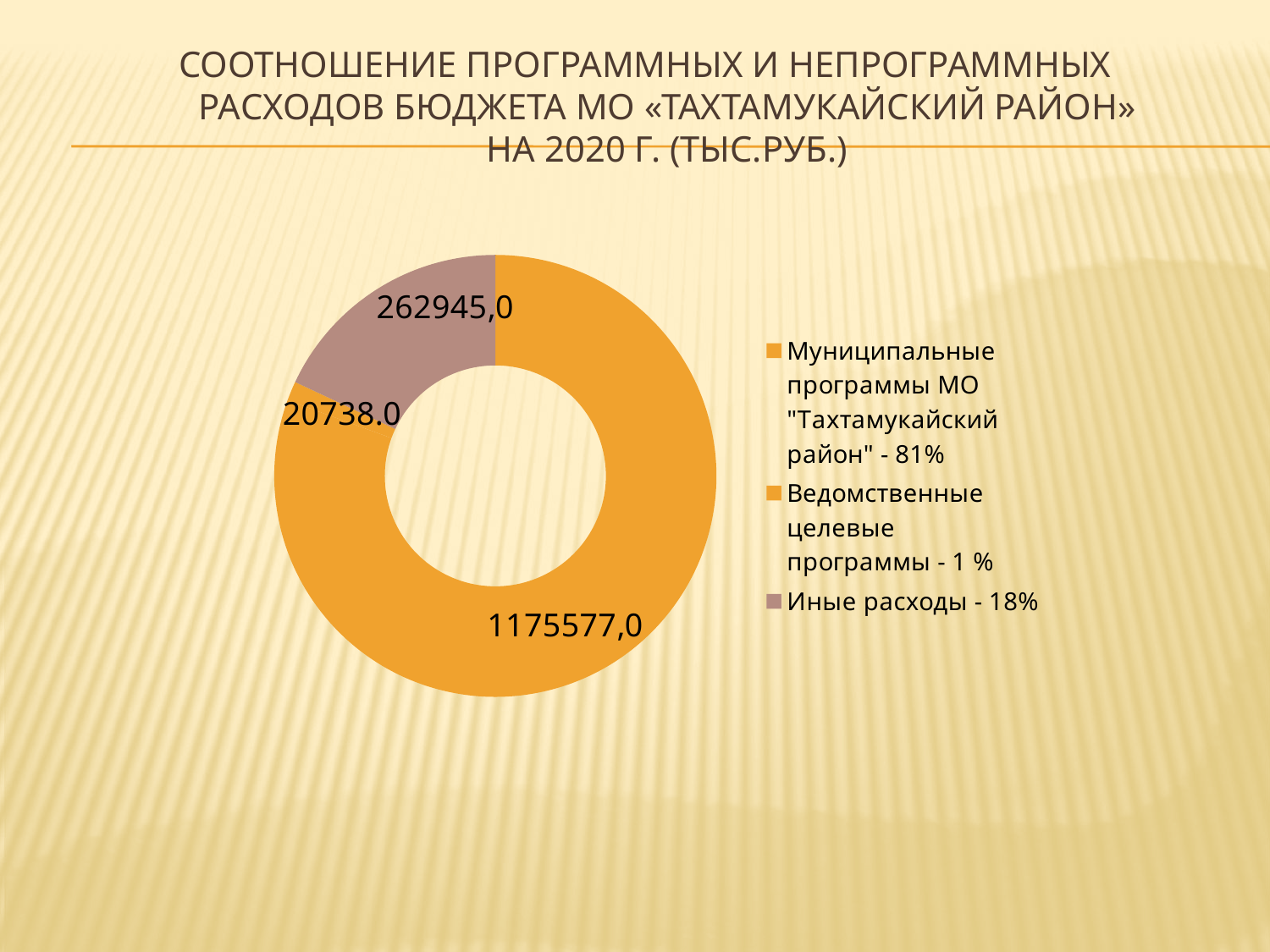
How many categories does the legend list? 3 Which category has the largest value? Муниципальные программы МО "Тахтамукайский район" What value is shown for Ведомственные целевые программы? 20738.0 What share of the chart do Муниципальные программы МО "Тахтамукайский район" represent, according to the legend? 81% What value is shown for Муниципальные программы МО "Тахтамукайский район"? 1175577,0 What value is shown for Иные расходы? 262945,0 Which category has the smallest value? Ведомственные целевые программы What is the difference between the values for Иные расходы and Ведомственные целевые программы? 242207,0 What kind of chart is shown on the slide? doughnut chart Which is larger: Иные расходы or Ведомственные целевые программы? Иные расходы What is the difference between the values for Муниципальные программы МО "Тахтамукайский район" and Иные расходы? 912632,0 What share of the chart do Иные расходы represent, according to the legend? 18%